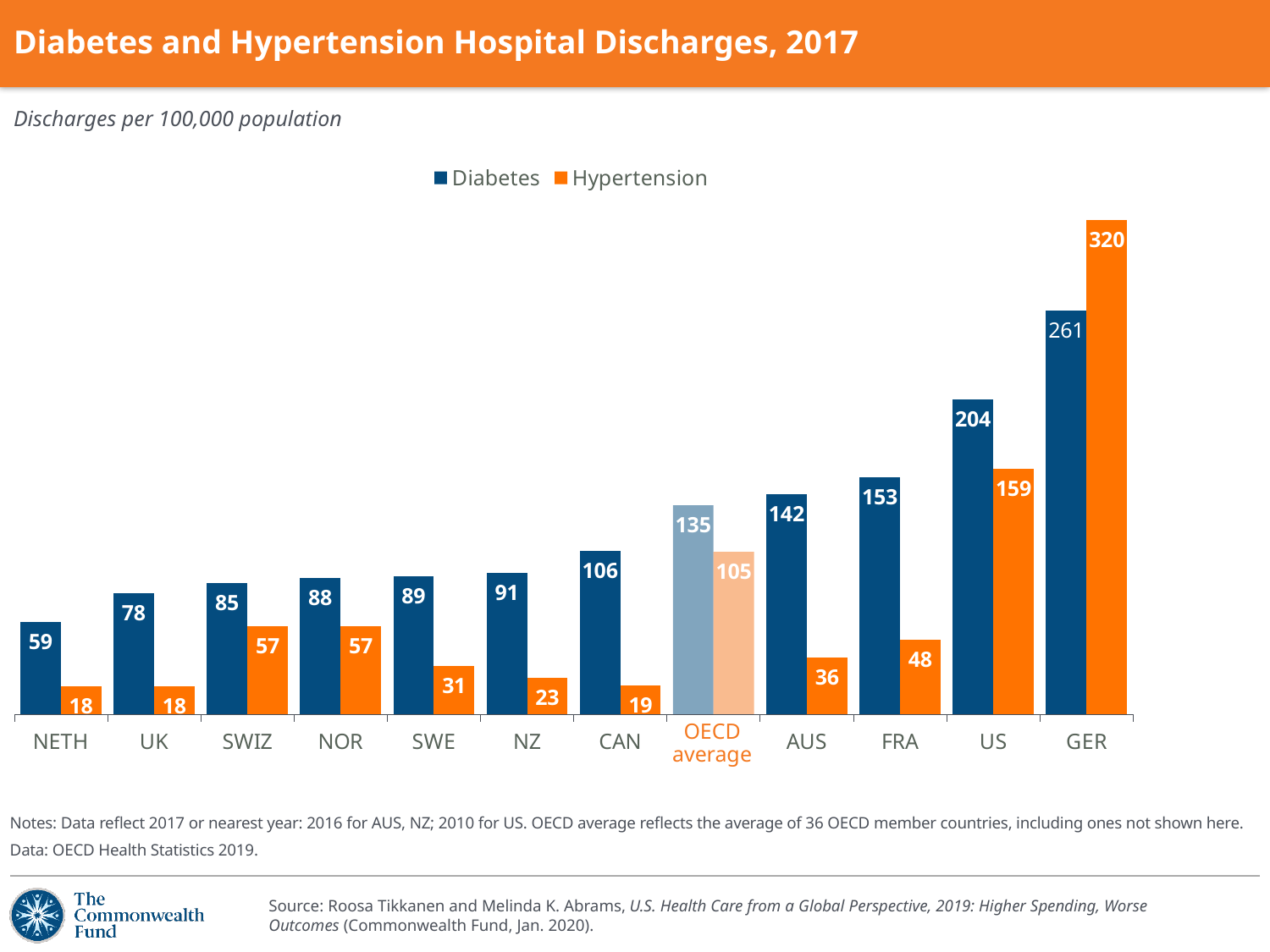
What is the Hypertension value for the OECD average? 105 Which is larger: the Diabetes value for FRA or the Diabetes value for AUS? FRA Which country has the lowest Diabetes discharge value? NETH What unit is stated for the values in the chart? Discharges per 100,000 population Do the Diabetes values generally rise or fall from left to right along the x axis? Rise What is the Diabetes discharge value for the US? 204 What is the Hypertension discharge value for Germany (GER)? 320 What is the difference between the Diabetes and Hypertension values for the US? 45 How many countries or groups are shown on the x axis? 12 Which country has the highest Diabetes discharge value? GER How many series does the legend list? 2 What kind of chart is shown on the slide? Bar chart